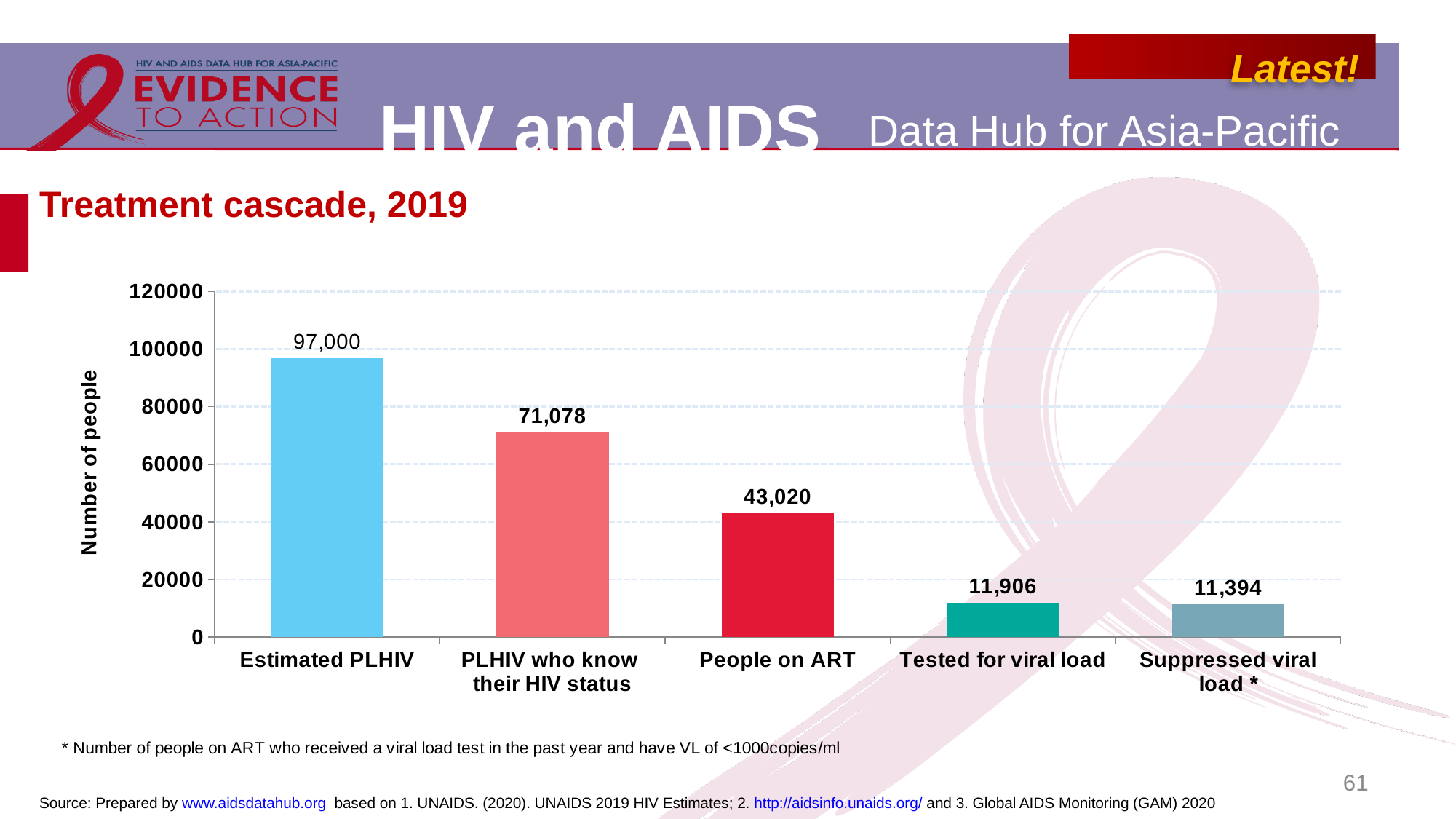
What is the value for People on ART? 43,020 How many categories are shown on the x axis? 5 What is the value for Suppressed viral load? 11,394 What is the difference between Estimated PLHIV and PLHIV who know their HIV status? 25,922 What kind of chart is shown on the slide? Bar chart Which category has the lowest value? Suppressed viral load What is the value for Tested for viral load? 11,906 Which is larger, the value for People on ART or the value for PLHIV who know their HIV status? PLHIV who know their HIV status What is the value for Estimated PLHIV? 97,000 What is the value for PLHIV who know their HIV status? 71,078 Which category has the highest value? Estimated PLHIV What is the difference between People on ART and Tested for viral load? 31,114